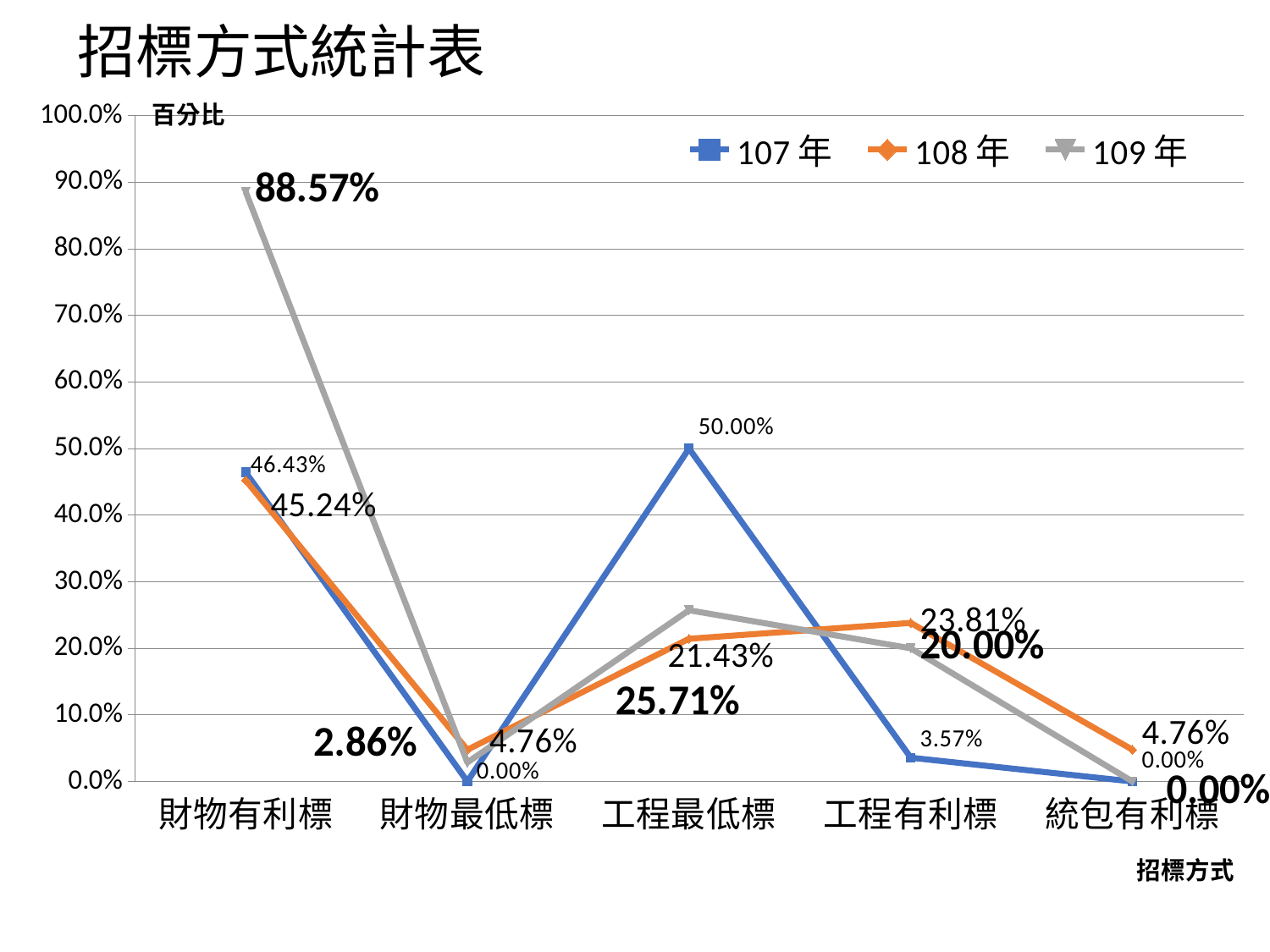
At 工程有利標, which series has the larger value, 108 年 or 109 年? 108 年 What is the value for 109 年 at 財物有利標? 88.57% Which category has the highest value for the 109 年 series? 財物有利標 How many series does the legend list? 3 What kind of chart is shown on the slide? line chart How many categories are shown on the x axis? 5 Which category has the lowest value for the 109 年 series? 統包有利標 What is the value for 107 年 at 工程最低標? 50.00% Is the value for 109 年 at 財物有利標 greater or less than 80.0%? greater What is the value for 108 年 at 統包有利標? 4.76% What is the difference between the 107 年 and 108 年 values at 財物有利標? 1.19% Does the 107 年 series rise or fall from 工程最低標 to 統包有利標? fall